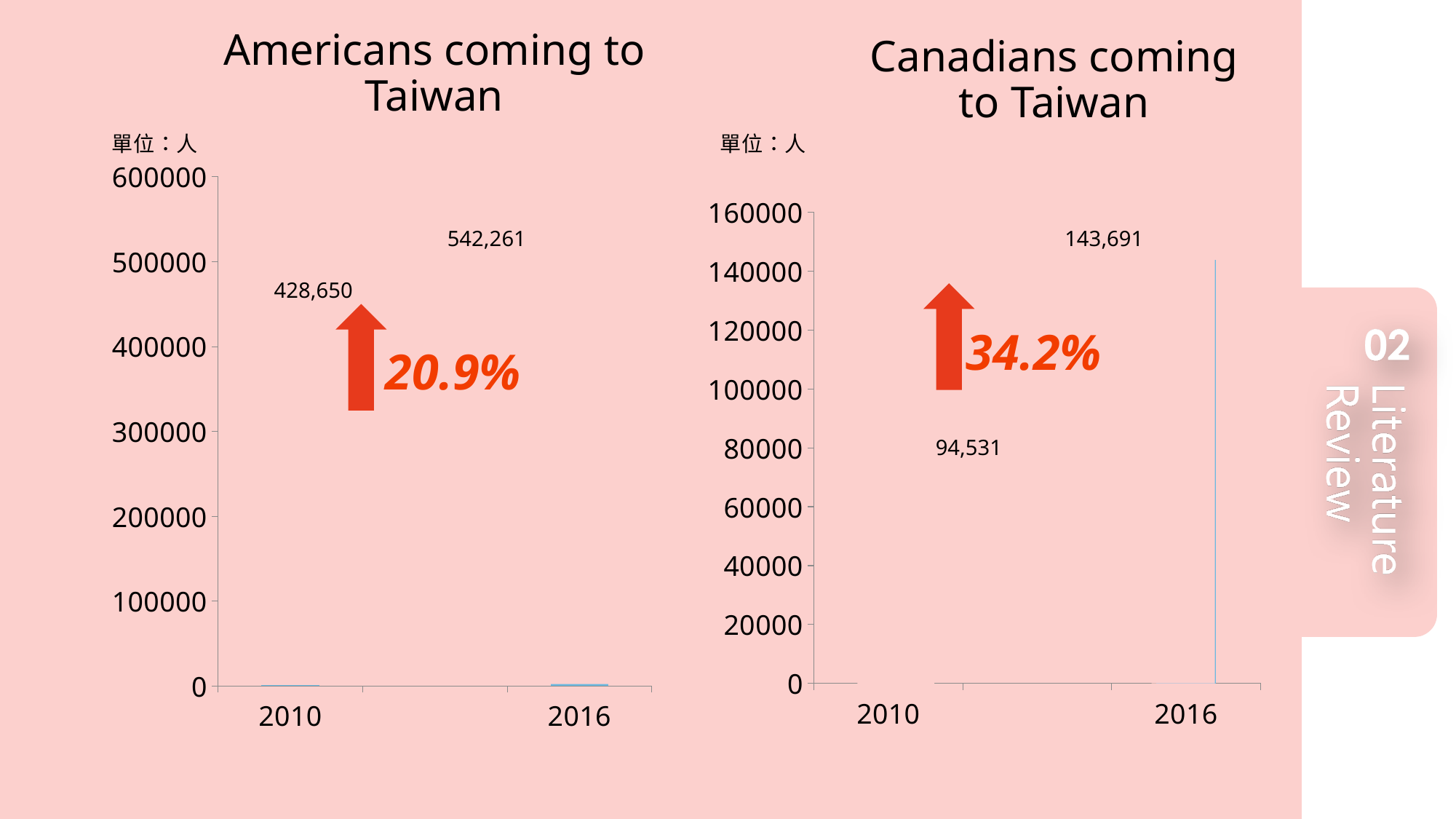
In the 'Canadians coming to Taiwan' chart, do the values rise or fall from 2010 to 2016? rise How many years are shown on the x axis of the 'Canadians coming to Taiwan' chart? 2 What percentage increase is annotated on the 'Americans coming to Taiwan' chart? 20.9% In the 'Americans coming to Taiwan' chart, what is the value for 2010? 428,650 In the 'Canadians coming to Taiwan' chart, which year has the lower value? 2010 In the 'Canadians coming to Taiwan' chart, what is the value for 2016? 143,691 In the 'Canadians coming to Taiwan' chart, what is the difference between the 2016 and 2010 values? 49,160 In the 'Americans coming to Taiwan' chart, what is the value for 2016? 542,261 In the 'Americans coming to Taiwan' chart, which year has the higher value? 2016 Is the 2016 value in the 'Americans coming to Taiwan' chart larger or smaller than the 2016 value in the 'Canadians coming to Taiwan' chart? larger In the 'Canadians coming to Taiwan' chart, what is the value for 2010? 94,531 In the 'Americans coming to Taiwan' chart, what is the difference between the 2016 and 2010 values? 113,611